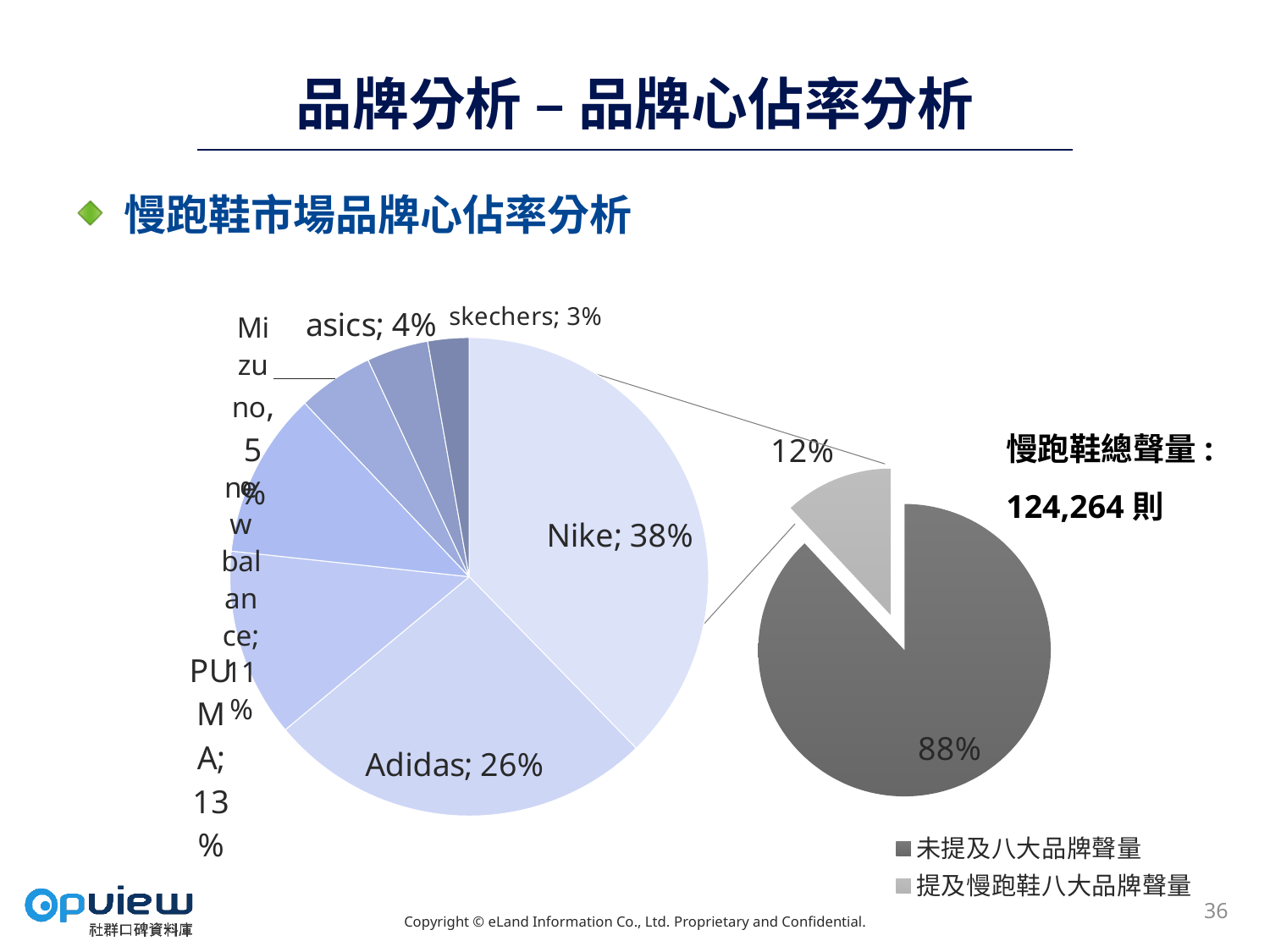
In the left pie, which has a larger share, PUMA or asics? PUMA In the left pie, which brand has the smallest share? skechers In the left pie, what is the difference in percentage points between Nike and Adidas? 12 In the left pie, what percentage is shown for Nike? 38% In the right pie, what share is labelled for 未提及八大品牌聲量? 88% What type of chart is shown on the slide? Pie chart In the left pie, what percentage is shown for asics? 4% In the left pie, what percentage is shown for Adidas? 26% In the left pie, which brand has the largest share? Nike What total volume (慢跑鞋總聲量) is stated next to the chart? 124,264 則 How many brand slices are shown in the left pie? 7 In the right pie, what share is labelled for 提及慢跑鞋八大品牌聲量? 12%